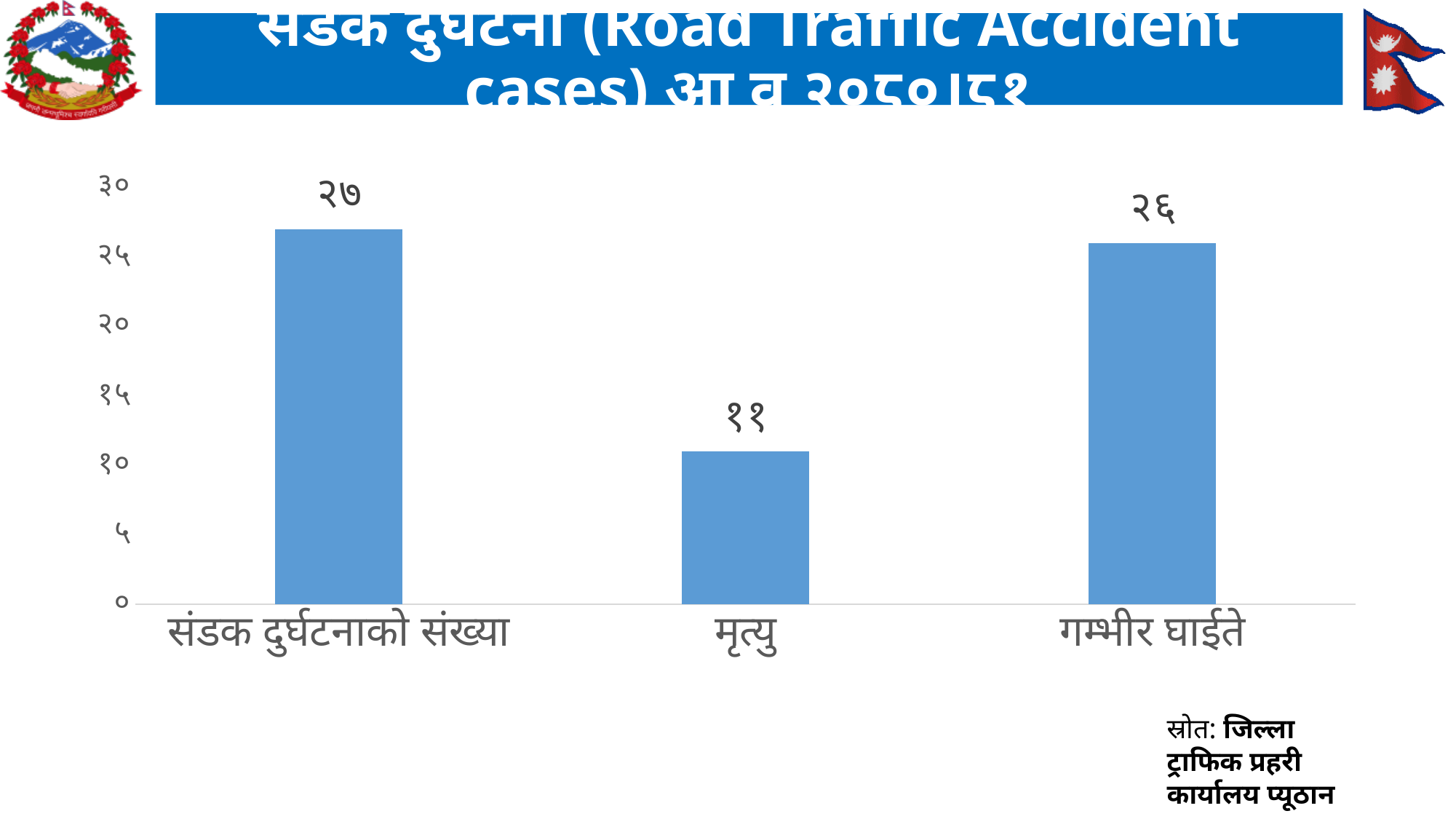
Which is larger, the value for सडक दुर्घटनाको संख्या or the value for गम्भीर घाईते? सडक दुर्घटनाको संख्या What is the highest tick value shown on the vertical axis? ३० Which category has the lowest value? मृत्यु What is the difference between the values for सडक दुर्घटनाको संख्या and मृत्यु? १६ What is the value shown for सडक दुर्घटनाको संख्या? २७ Is the value for मृत्यु greater or less than १५? less What is the value shown for गम्भीर घाईते? २६ How many categories are shown on the x axis? 3 What is the value shown for मृत्यु? ११ What kind of chart is shown on the slide? bar chart What is the difference between the values for गम्भीर घाईते and मृत्यु? १५ Which category has the highest value? सडक दुर्घटनाको संख्या